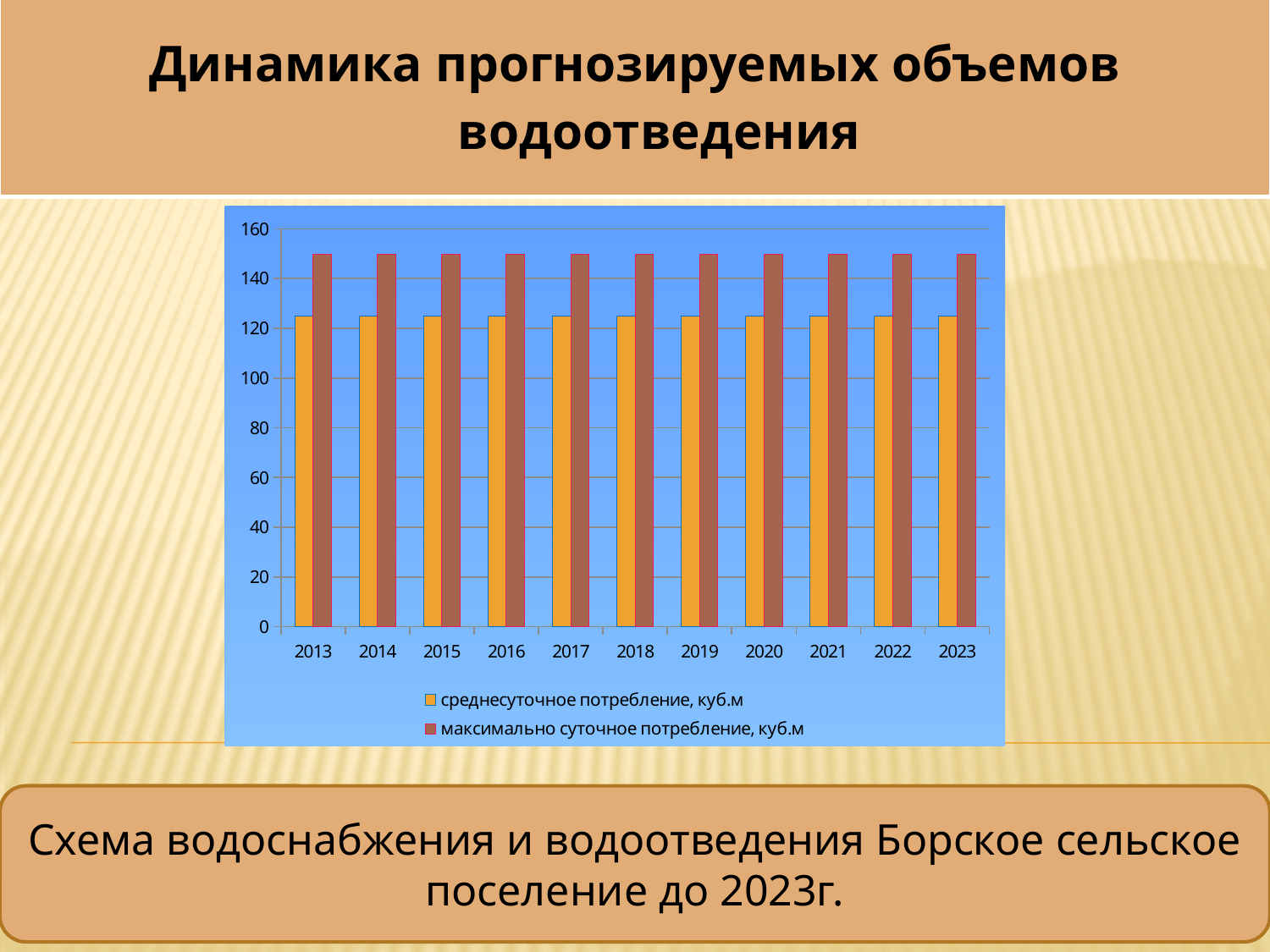
Do the values for максимально суточное потребление rise, fall, or stay the same across the years shown? stay the same Is the value for максимально суточное потребление in 2023 greater or less than 160? less Do the values for среднесуточное потребление rise, fall, or stay the same from 2013 to 2023? stay the same What is the title of the slide containing the chart? Динамика прогнозируемых объемов водоотведения What kind of chart is shown on the slide? bar chart Which series has the larger value in 2013: среднесуточное потребление or максимально суточное потребление? максимально суточное потребление, куб.м Is the value for среднесуточное потребление in 2020 greater or less than 140? less How many years are shown on the x axis of the chart? 11 What is the first year shown on the x axis of the chart? 2013 Is the value for среднесуточное потребление in 2015 greater or less than 100? greater How many series does the chart legend list? 2